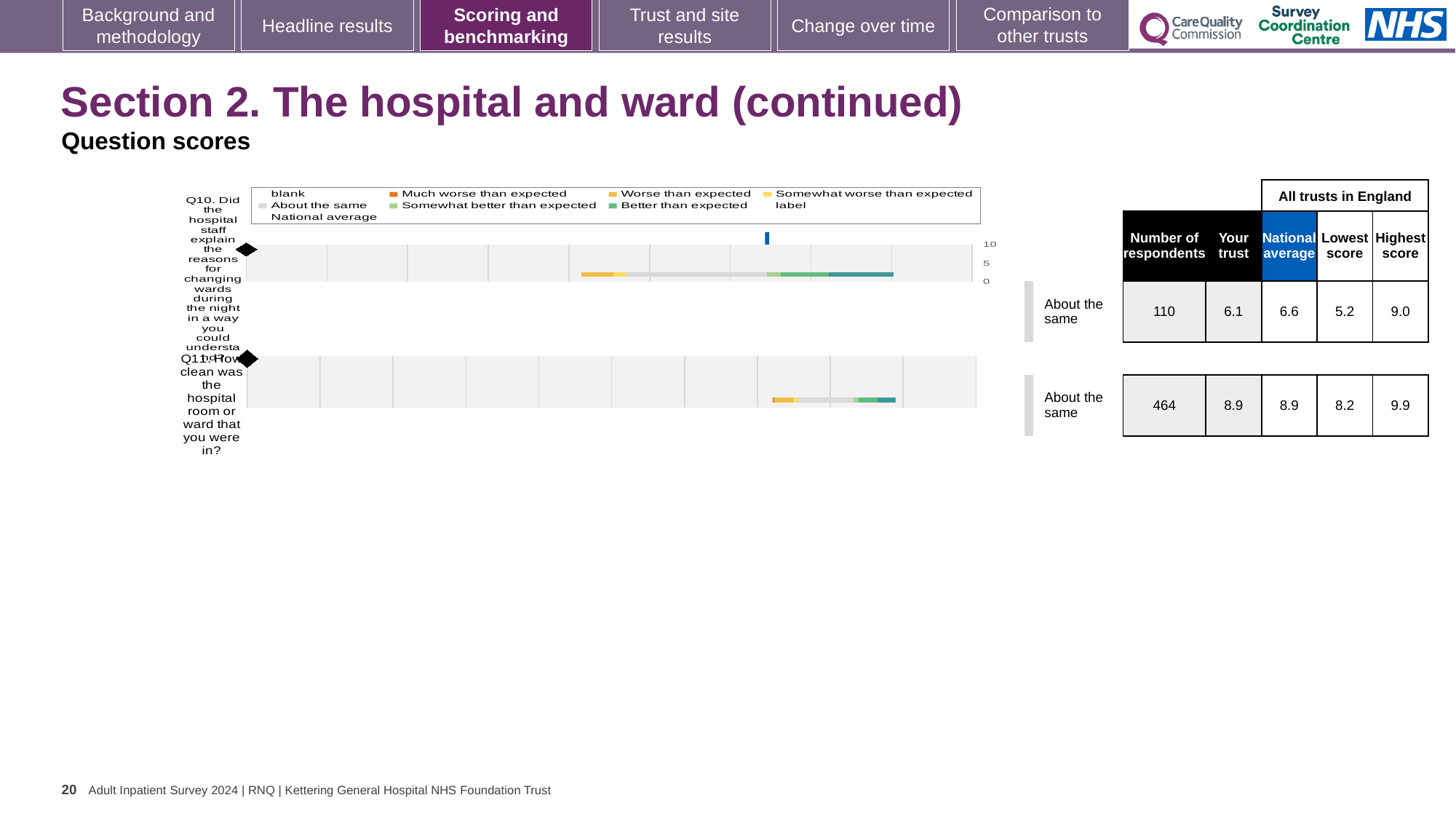
For the Q11 chart, what is the difference between the highest score and the lowest score among all trusts in England? 1.7 Which benchmarking category is shown for the Q10 chart? About the same How many questions are plotted on the slide's charts? 2 For the Q11 chart, what is the highest score among all trusts in England? 9.9 For the Q10 chart, how much higher is the national average than the 'Your trust' score? 0.5 For the Q11 chart (how clean was the hospital room or ward), what is the 'Your trust' score? 8.9 What kind of chart is used to show the question scores for Q10 and Q11? bar chart For the Q10 chart (explaining reasons for changing wards during the night), what is the 'Your trust' score? 6.1 For the Q10 chart, what is the national average score? 6.6 For the Q11 chart, how many respondents are there? 464 For the Q10 chart, what is the lowest score among all trusts in England? 5.2 Which question has the higher 'Your trust' score, Q10 or Q11? Q11